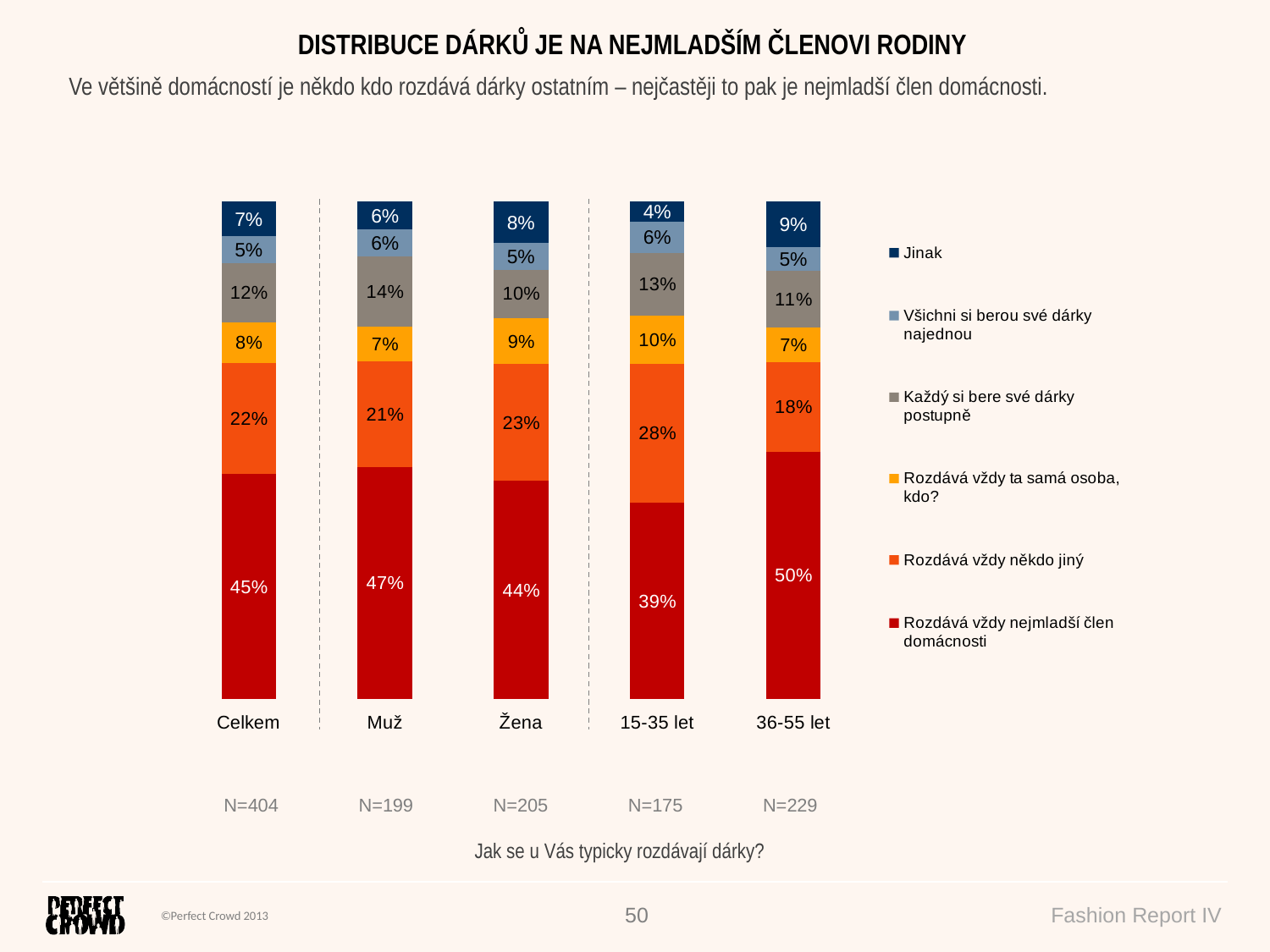
What is the value for "Rozdává vždy nejmladší člen domácnosti" in the Celkem bar? 45% How many categories are shown on the x axis of the chart? 5 What is the value for "Rozdává vždy někdo jiný" in the 15-35 let bar? 28% What is the difference between the "Rozdává vždy nejmladší člen domácnosti" values for Muž and Žena? 3 percentage points What is the sample size (N) shown under the Celkem bar? N=404 Which category has the lowest value for "Rozdává vždy nejmladší člen domácnosti"? 15-35 let What kind of chart is shown on the slide? Stacked bar chart Which has the larger "Jinak" value, 15-35 let or 36-55 let? 36-55 let What is the value for "Všichni si berou své dárky najednou" in the Žena bar? 5% How many series does the legend list? 6 What is the value for "Každý si bere své dárky postupně" in the Muž bar? 14% Which category has the highest value for "Rozdává vždy nejmladší člen domácnosti"? 36-55 let